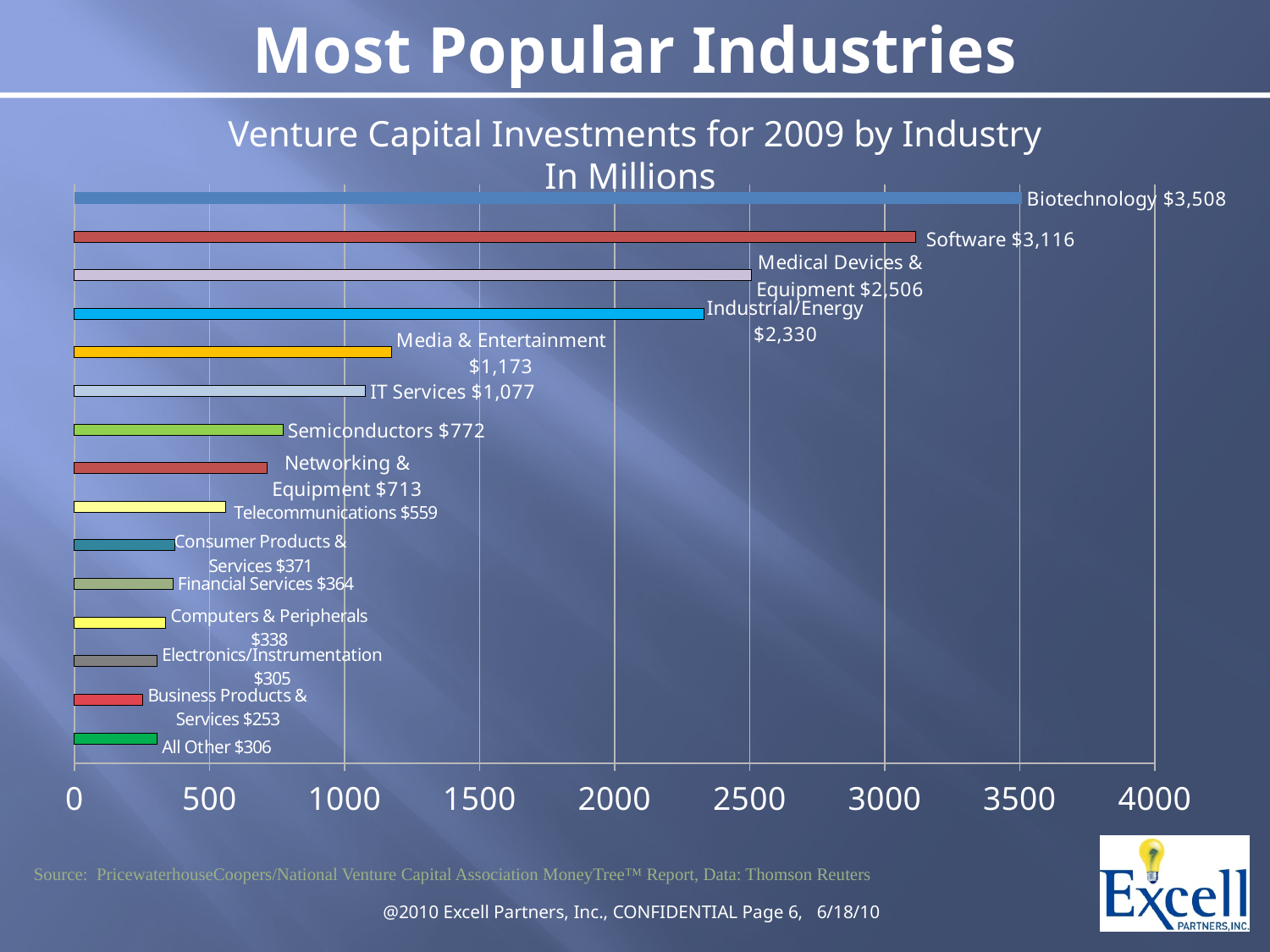
Which industry has the highest venture capital investment? Biotechnology What is the value shown for Semiconductors? $772 What is the venture capital investment value for Biotechnology? $3,508 What is the value shown for Software? $3,116 Which is larger, the value for Media & Entertainment or the value for IT Services? Media & Entertainment Which industry has the lowest venture capital investment? Business Products & Services What is the difference between the values for Biotechnology and Software? $392 What is the value shown for Telecommunications? $559 What is the title of the chart? Venture Capital Investments for 2009 by Industry In Millions How many industries are shown in the chart? 15 What is the difference between the values for Medical Devices & Equipment and Industrial/Energy? $176 What kind of chart is shown on the slide? Bar chart